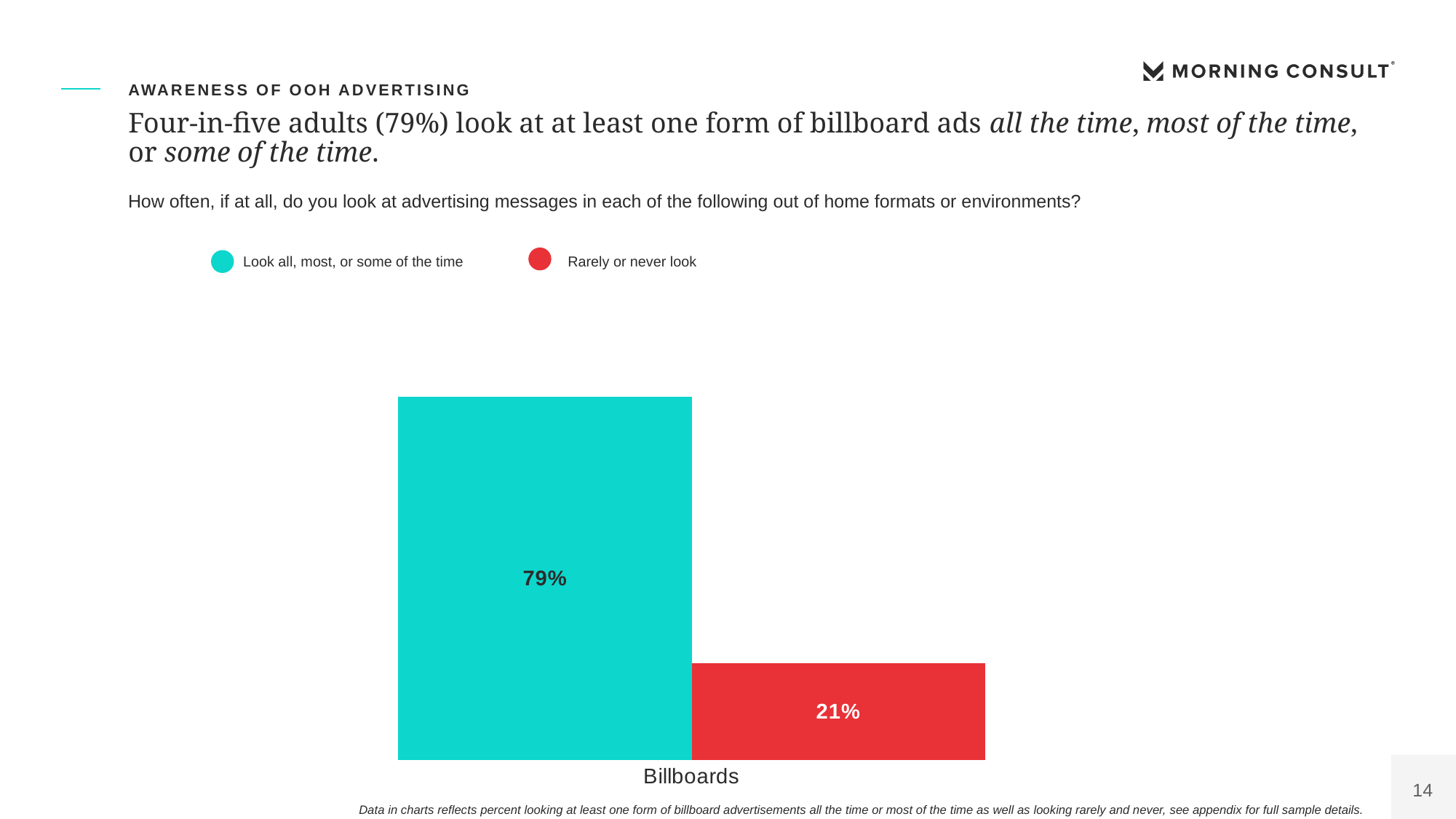
What is the total of the two values shown for Billboards? 100% What percentage of adults rarely or never look at billboard ads? 21% What is the category label on the x axis? Billboards What colour represents 'Rarely or never look' in the chart? Red What is the difference in percentage points between those who look all, most, or some of the time and those who rarely or never look at billboards? 58 Which series has the lowest value in the chart? Rarely or never look Which series has the higher value for Billboards: 'Look all, most, or some of the time' or 'Rarely or never look'? Look all, most, or some of the time How many categories are shown on the x axis? 1 How many series does the legend list? 2 What percentage of adults look at billboard ads all, most, or some of the time? 79% What kind of chart is shown on the slide? Bar chart